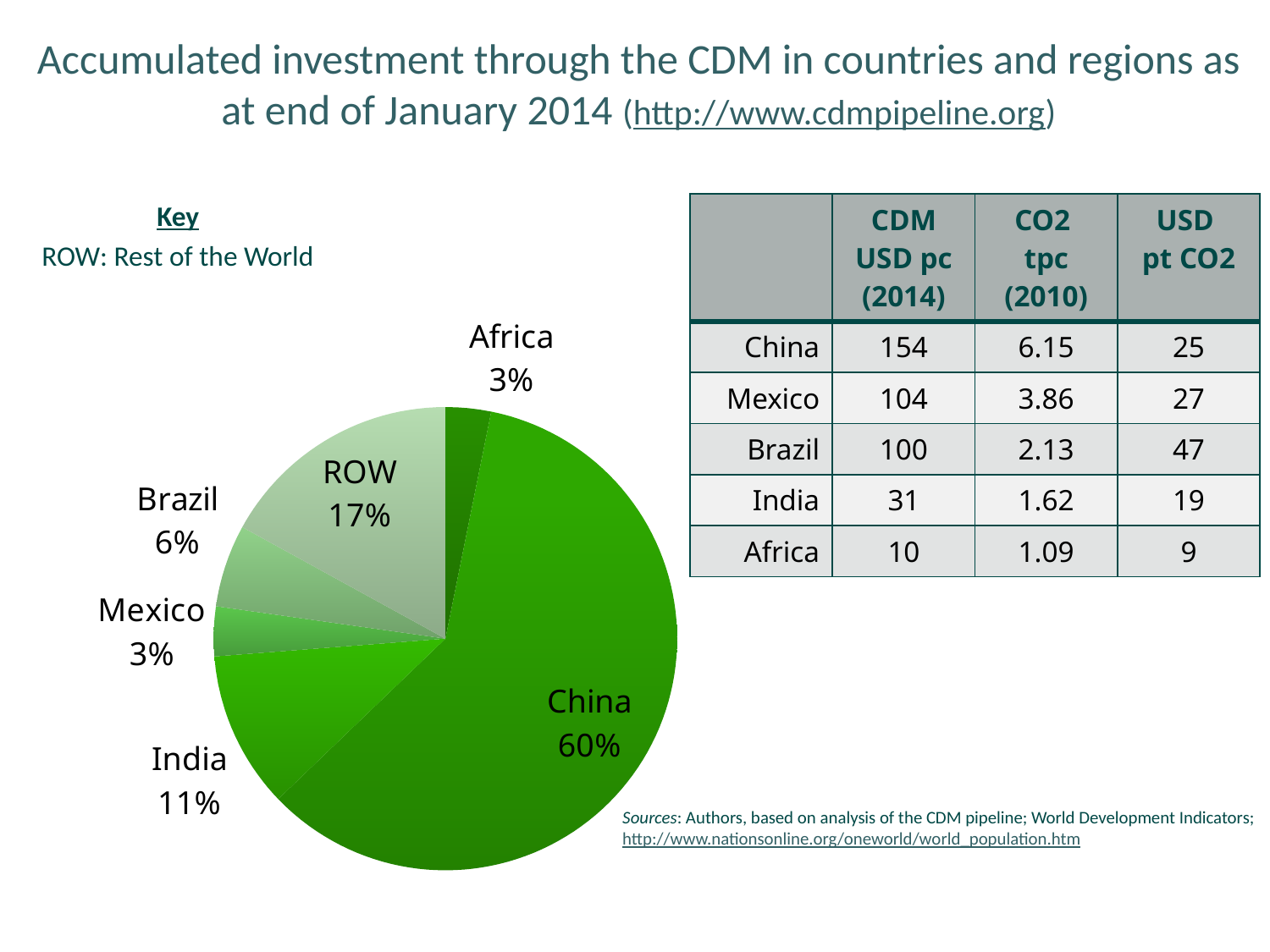
What is the value shown for Africa in the pie chart? 3% What is the difference in percentage points between China's share and ROW's share? 43 What kind of chart is shown on the slide? pie chart What is the value shown for Brazil in the pie chart? 6% Which category has the largest slice of the pie? China What is the combined share of India and Mexico in the pie chart? 14% How many slices does the pie chart have? 6 What is the value shown for ROW in the pie chart? 17% What is the value shown for India in the pie chart? 11% Which slice is larger, India or Brazil? India According to the key on the slide, what does ROW stand for? Rest of the World What share of the pie does China account for? 60%